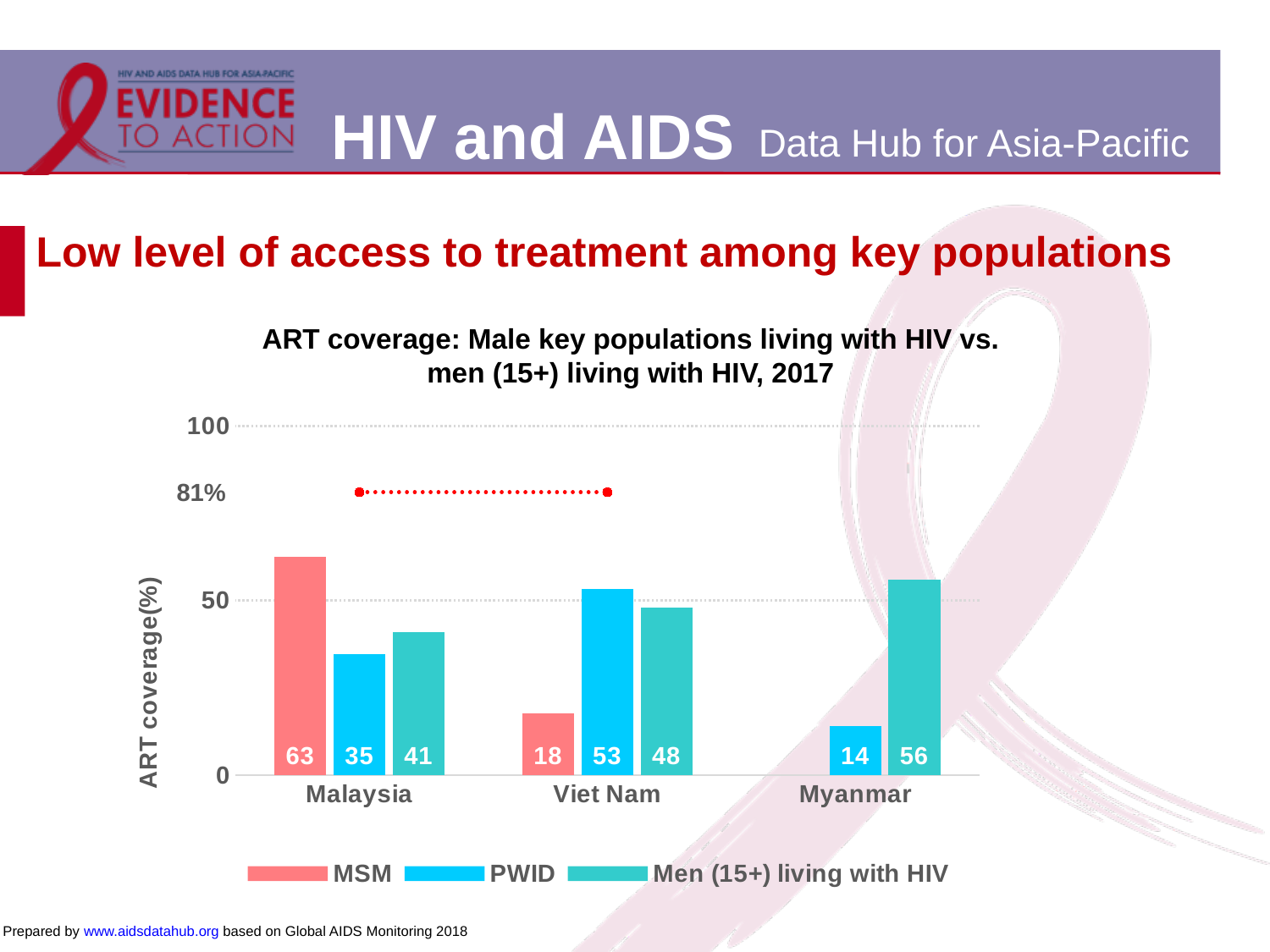
What is the ART coverage for MSM in Malaysia? 63 Which country has the highest ART coverage for MSM? Malaysia How many countries are shown on the x axis? 3 What is the ART coverage for PWID in Viet Nam? 53 What is the ART coverage for men (15+) living with HIV in Myanmar? 56 What is the ART coverage for PWID in Myanmar? 14 Which country has the lowest ART coverage for PWID? Myanmar What is the difference between the ART coverage for MSM and PWID in Malaysia? 28 Which is larger in Viet Nam, the ART coverage for PWID or for men (15+) living with HIV? PWID Is the ART coverage for MSM in Viet Nam greater or less than 50? less What kind of chart is shown on the slide? bar chart How many series does the legend list? 3